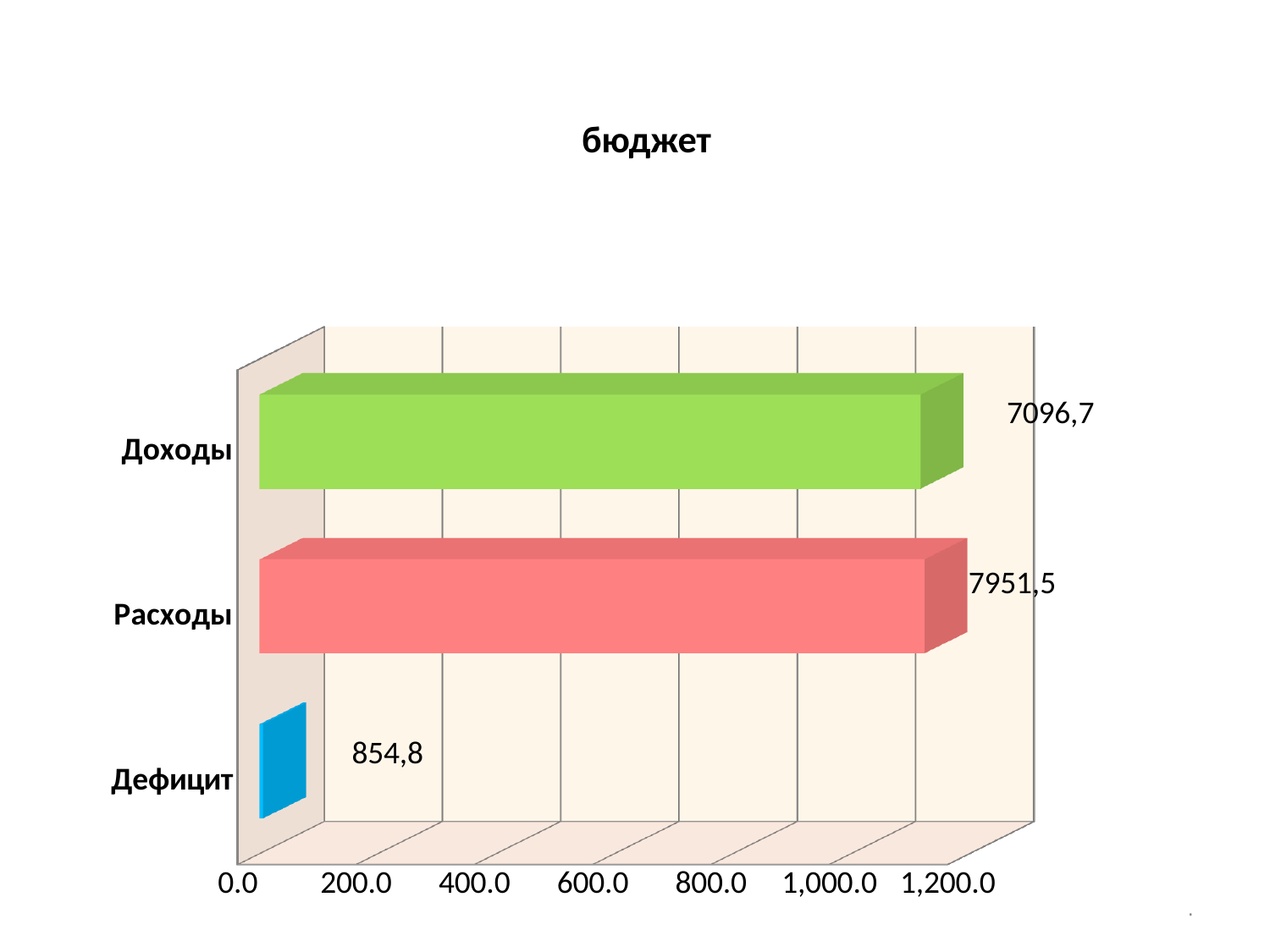
Which category has the lowest value? Дефицит What kind of chart is shown on the slide? bar chart What is the value shown for Расходы? 7951,5 Which is larger, the value for Доходы or the value for Расходы? Расходы What is the value shown for Доходы? 7096,7 Which category has the highest value? Расходы How many categories are shown in the chart? 3 Is the bar for Дефицит greater or less than 200.0 on the axis? less What is the title of the chart? бюджет Is the bar for Доходы greater or less than 1,000.0 on the axis? greater What is the difference between the values for Расходы and Доходы? 854,8 What is the value shown for Дефицит? 854,8